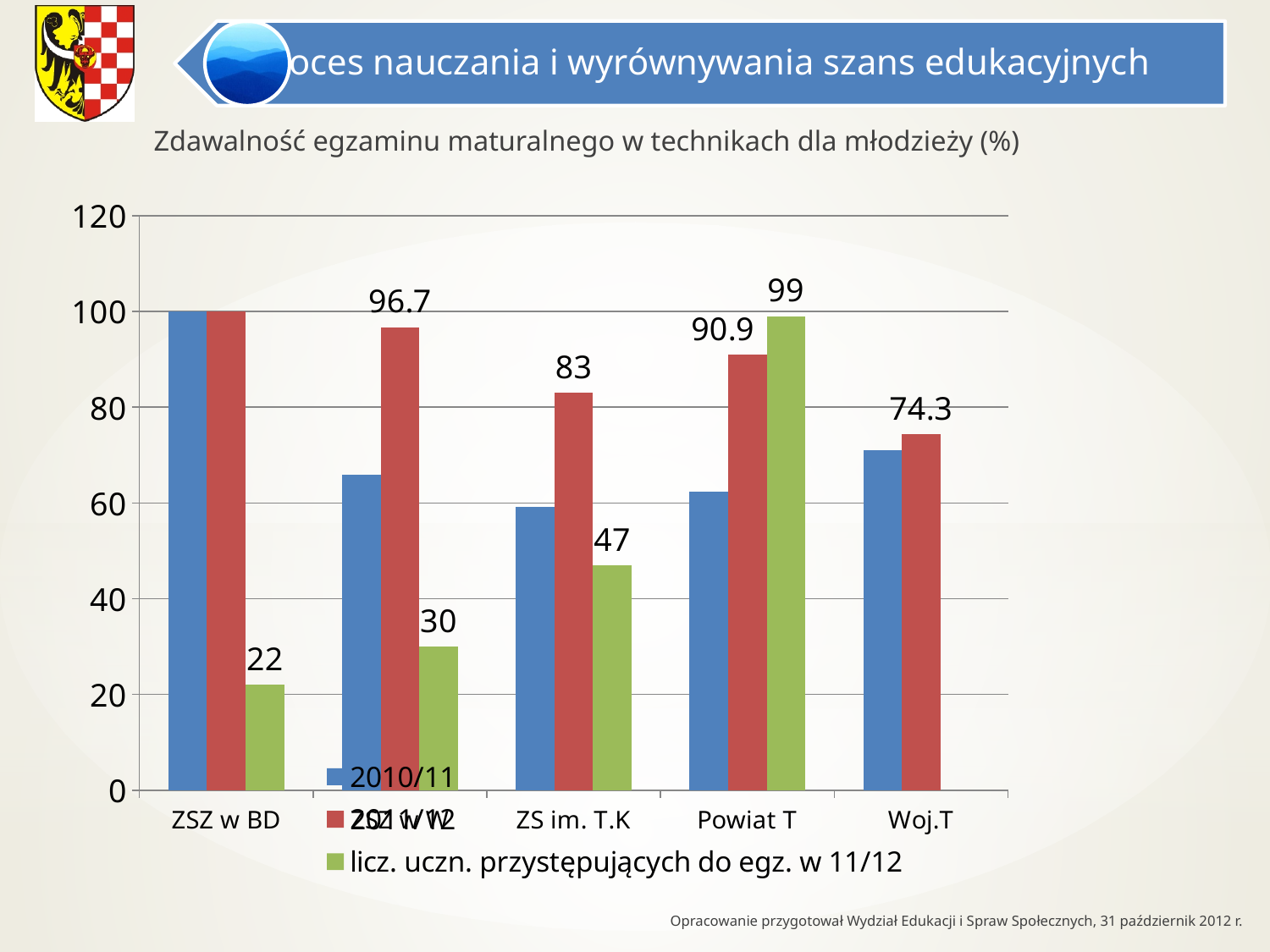
Is the 2010/11 (blue) value for ZSZ w W greater or less than 60? greater Which category has the lowest 2011/12 (red) value? Woj.T How many categories are shown on the x axis? 5 What is the difference between the 2011/12 (red) values for ZSZ w W and ZS im. T.K? 13.7 Which has the larger 2011/12 (red) value, Powiat T or ZS im. T.K? Powiat T What is the 2011/12 (red) value for Woj.T? 74.3 What is the value of the green series (licz. uczn. przystępujących do egz. w 11/12) for Powiat T? 99 What is the difference between the green series values for Powiat T and ZS im. T.K? 52 Which category has the lowest value in the green series (licz. uczn. przystępujących do egz. w 11/12)? ZSZ w BD What is the 2011/12 (red) value for ZSZ w W? 96.7 Is the 2010/11 (blue) value for Powiat T greater or less than 80? less How many series does the legend list? 3